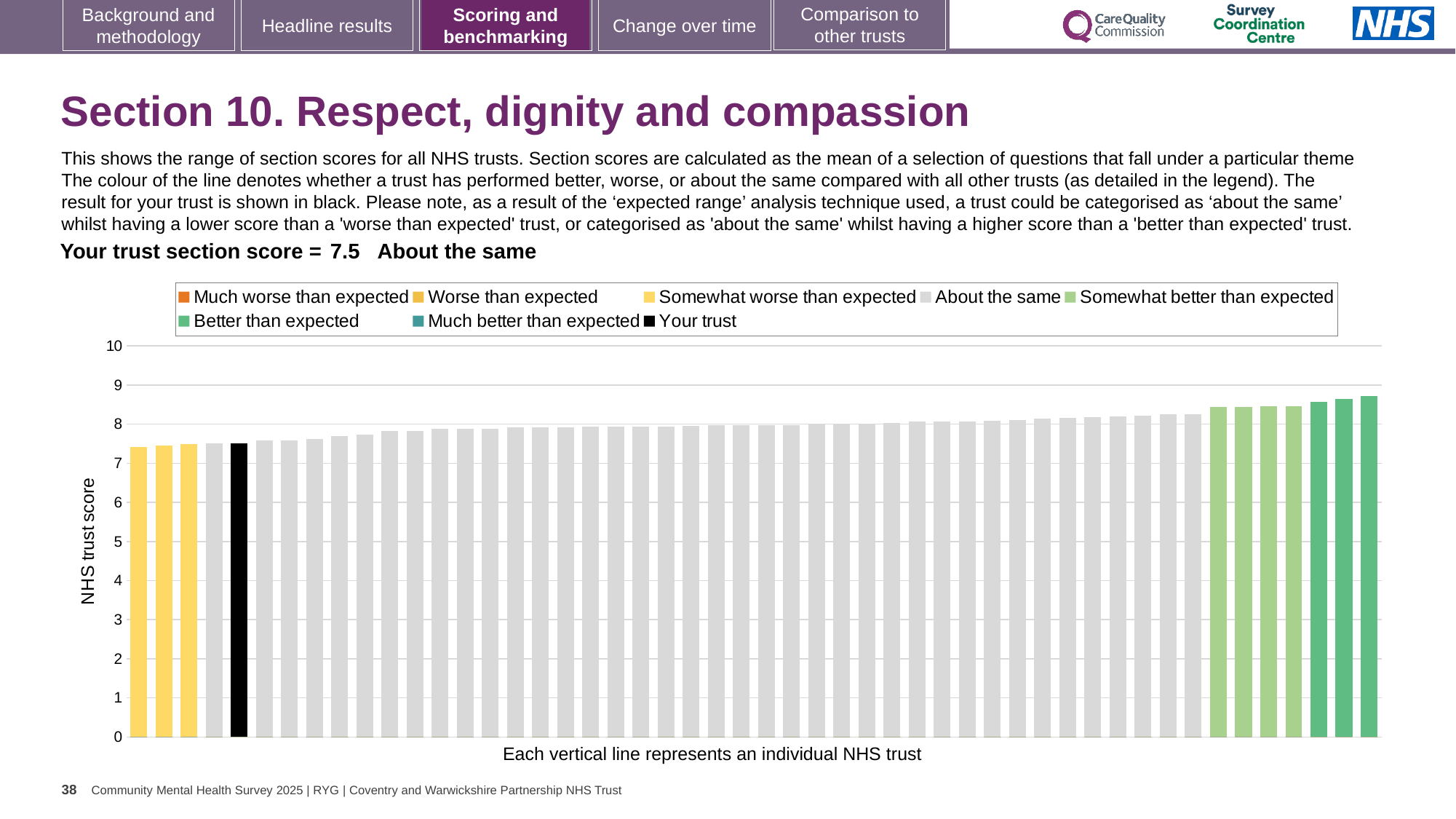
Is the value of the leftmost bar greater or less than 8? less Which category is your trust's section score placed in? About the same What kind of chart is shown on the slide? Bar chart How many bars are coloured yellow (somewhat worse than expected)? 3 Is the value for your trust (the black bar) greater or less than 7? greater Is the value of the tallest bar greater or less than 8? greater How many entries does the chart legend list? 8 Do the bar values rise or fall from left to right across the chart? Rise What is the label on the vertical axis of the chart? NHS trust score Which bar is taller: the black 'Your trust' bar or the rightmost green bar? The rightmost green bar What is the highest value shown on the vertical axis? 10 What is the section score for your trust shown on the slide? 7.5